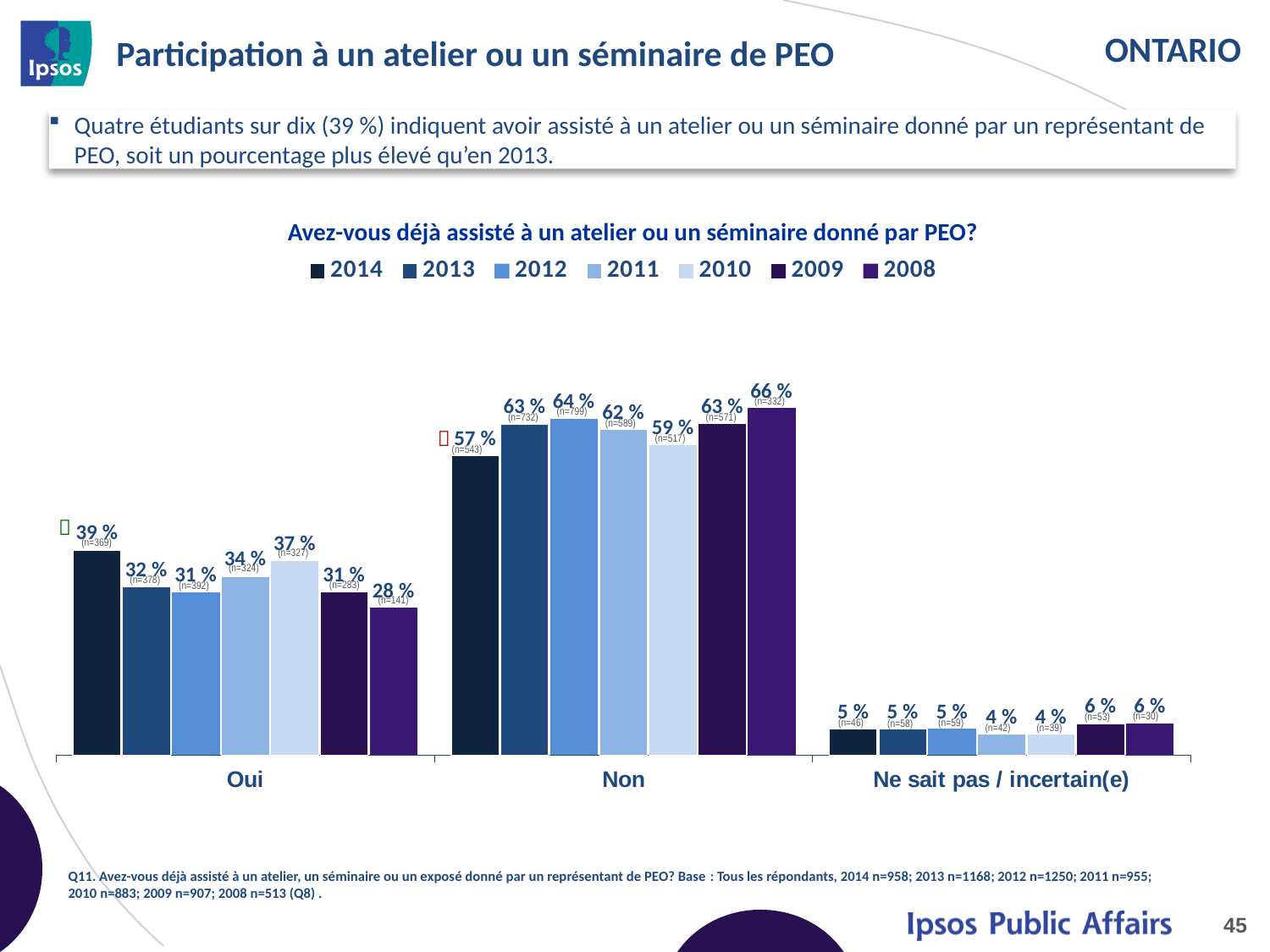
Which year has the highest value in the "Oui" category? 2014 How many series does the legend list? 7 How many categories are shown on the x axis? 3 What is the difference between the 2008 and 2014 values in the "Non" category? 9 % What percentage of respondents in 2014 answered "Oui"? 39 % What is the value for 2008 in the "Non" category? 66 % Which year has the lowest value in the "Non" category? 2014 What is the value for 2011 in the "Ne sait pas / incertain(e)" category? 4 % What is the difference between the 2014 and 2013 values in the "Oui" category? 7 % What kind of chart is shown on the slide? Bar chart Which is larger: the 2010 value for "Oui" or the 2011 value for "Oui"? 2010 What is the title of the chart? Avez-vous déjà assisté à un atelier ou un séminaire donné par PEO?